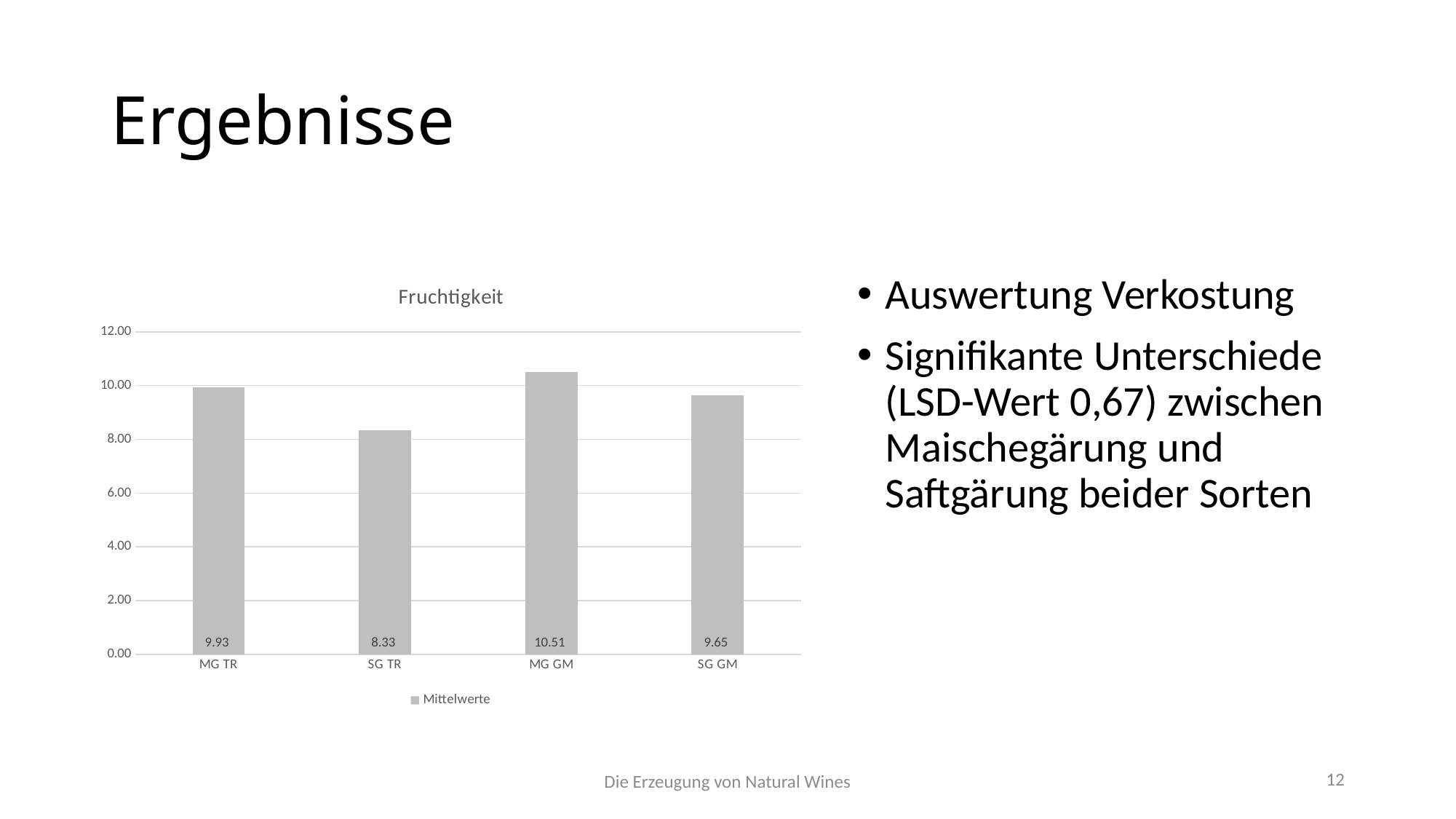
How many categories are shown in the Fruchtigkeit chart? 4 What is the value for SG GM in the Fruchtigkeit chart? 9.65 What is the value for SG TR in the Fruchtigkeit chart? 8.33 What is the difference between the values for MG GM and SG TR? 2.18 What series name does the legend of the chart show? Mittelwerte Which category has the highest value in the Fruchtigkeit chart? MG GM What is the value for MG TR in the Fruchtigkeit chart? 9.93 Is the value for MG GM greater or less than 10.00? greater Which is larger, the value for MG TR or the value for SG GM? MG TR What is the value for MG GM in the Fruchtigkeit chart? 10.51 Which category has the lowest value in the Fruchtigkeit chart? SG TR What kind of chart is shown on the slide? bar chart